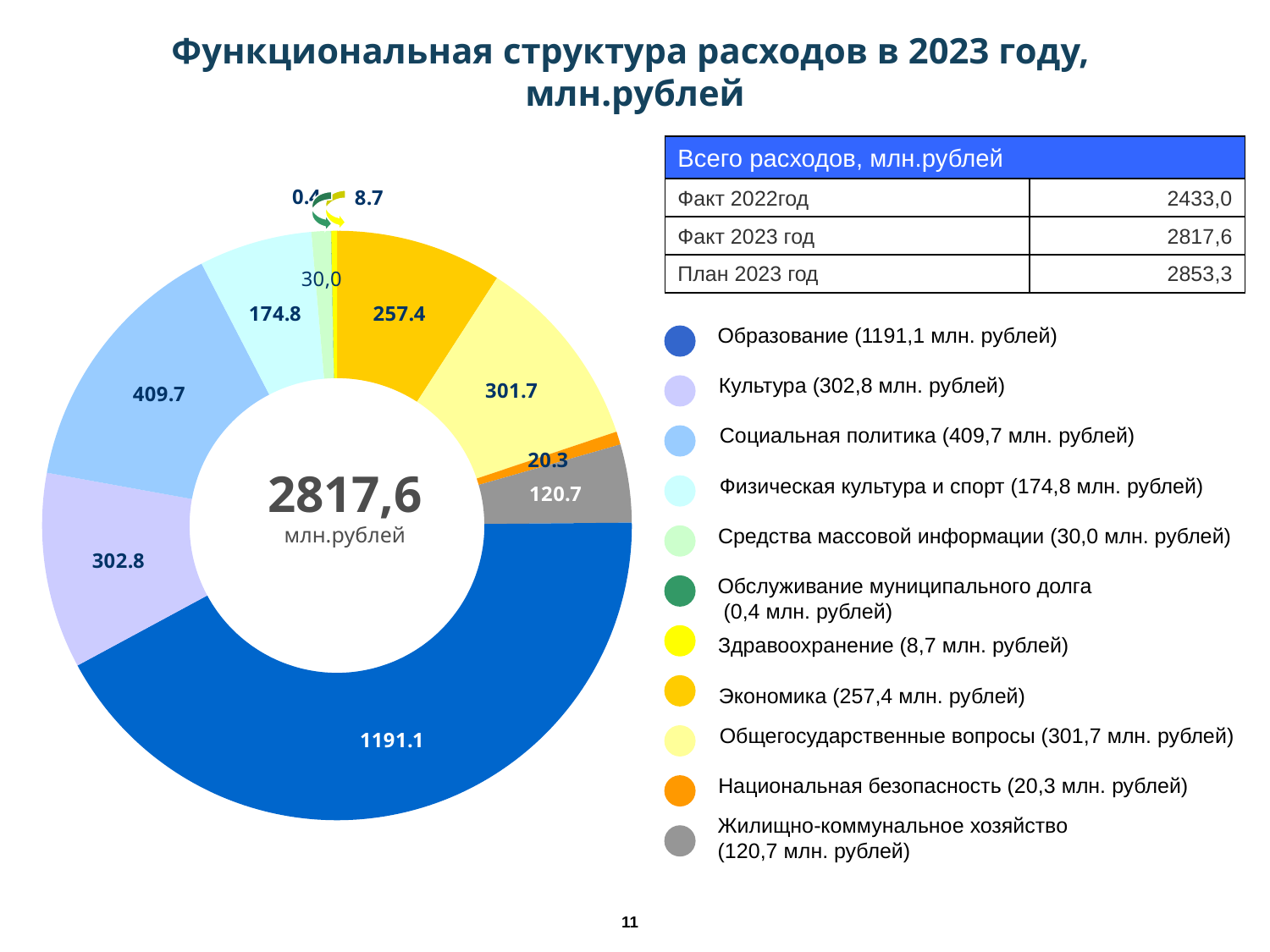
How many categories are shown in the chart? 11 What is the value for Образование in the chart? 1191.1 Which category has the smallest value in the chart? Обслуживание муниципального долга Which category has the largest share of expenditures in the chart? Образование What is the difference between Социальная политика and Культура? 106.9 What type of chart is shown on the slide? Pie (donut) chart What is the value for Социальная политика in the chart? 409.7 What is the difference between Экономика and Жилищно-коммунальное хозяйство? 136.7 Which is larger, Физическая культура и спорт or Экономика? Экономика What is the value for Здравоохранение in the chart? 8.7 What total value is shown in the centre of the donut chart? 2817,6 млн.рублей What is the value for Жилищно-коммунальное хозяйство in the chart? 120.7